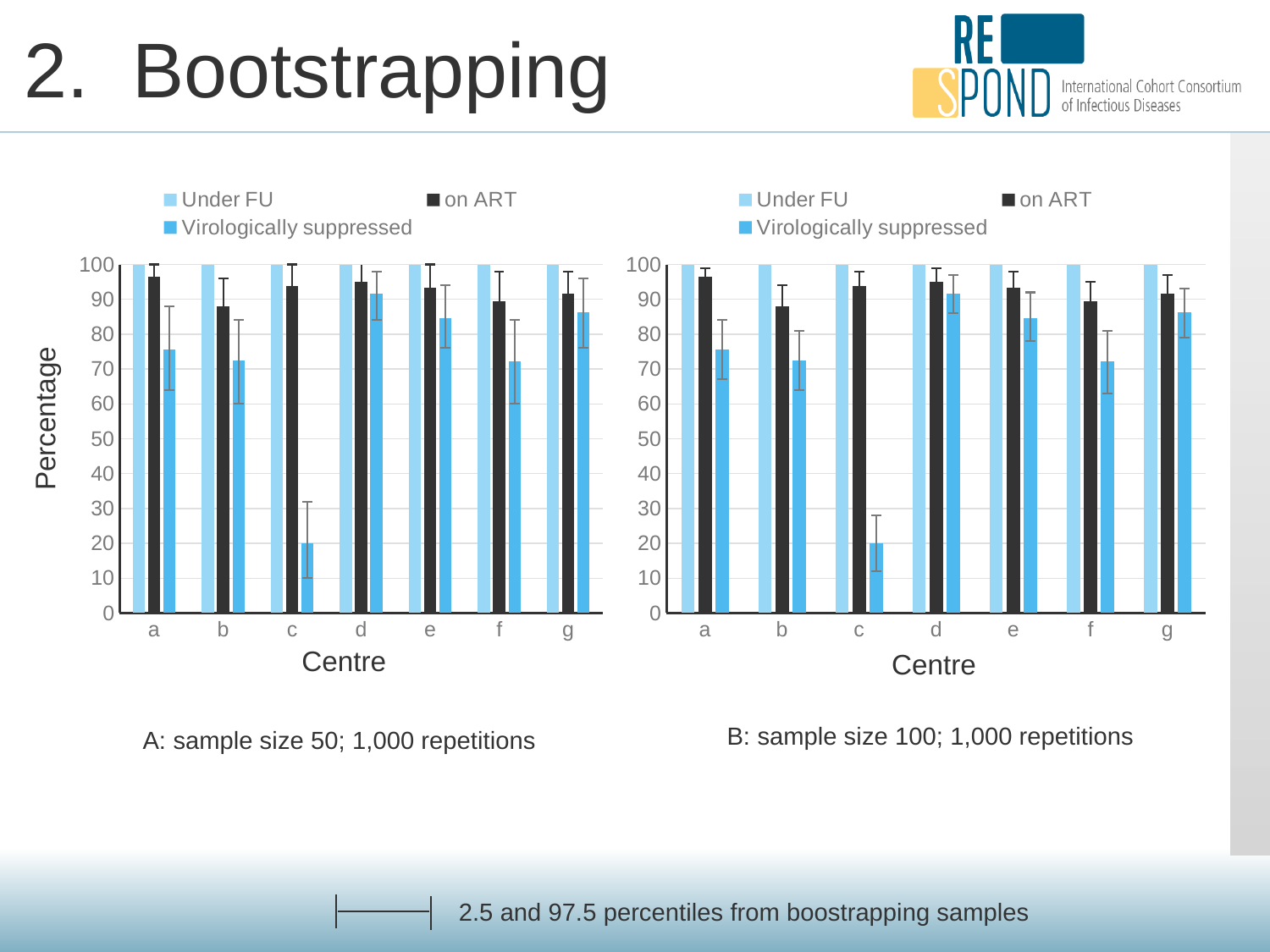
What is the x-axis title of chart B (sample size 100)? Centre In chart A (sample size 50), which centre has the lowest Virologically suppressed value? c What kind of chart is chart A (sample size 50)? bar chart In chart B (sample size 100), which is larger for centre f: the on ART value or the Virologically suppressed value? on ART In chart B (sample size 100), which centre has the lowest Virologically suppressed value? c What is the y-axis title of chart A (sample size 50)? Percentage In chart A (sample size 50), which is larger: the Virologically suppressed value for centre d or for centre c? centre d In chart A (sample size 50), is the on ART value for centre b greater or less than 80? greater In chart B (sample size 100), how many series does the legend list? 3 In chart A (sample size 50), how many centres are shown on the x axis? 7 In chart A (sample size 50), is the Virologically suppressed value for centre a greater or less than 60? greater In chart B (sample size 100), is the Virologically suppressed value for centre c greater or less than 50? less